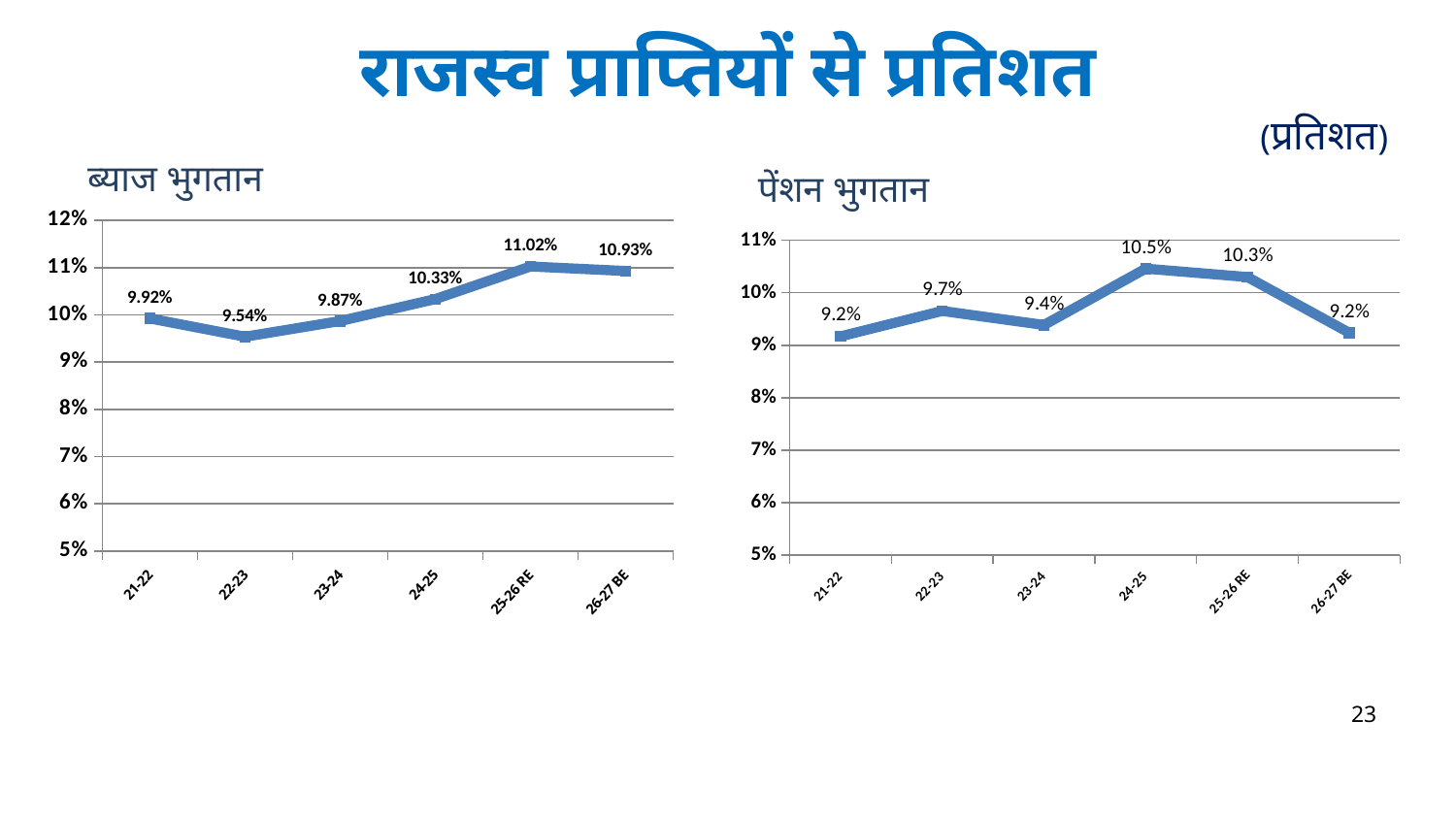
In the right chart titled पेंशन भुगतान, what is the value for 26-27 BE? 9.2% In the right chart titled पेंशन भुगतान, what is the difference between the values for 24-25 and 21-22? 1.3% What type of chart is the right chart titled पेंशन भुगतान? Line chart How many data points are plotted in the left chart titled ब्याज भुगतान? 6 In the left chart titled ब्याज भुगतान, what is the value for 22-23? 9.54% In the left chart titled ब्याज भुगतान, what is the difference between the values for 25-26 RE and 26-27 BE? 0.09% In the left chart titled ब्याज भुगतान, what is the value for 25-26 RE? 11.02% In the right chart titled पेंशन भुगतान, which is larger, the value for 22-23 or the value for 23-24? 22-23 In the right chart titled पेंशन भुगतान, which year has the highest value? 24-25 In the right chart titled पेंशन भुगतान, what is the value for 24-25? 10.5% In the left chart titled ब्याज भुगतान, which year has the lowest value? 22-23 In the left chart titled ब्याज भुगतान, which year has the highest value? 25-26 RE